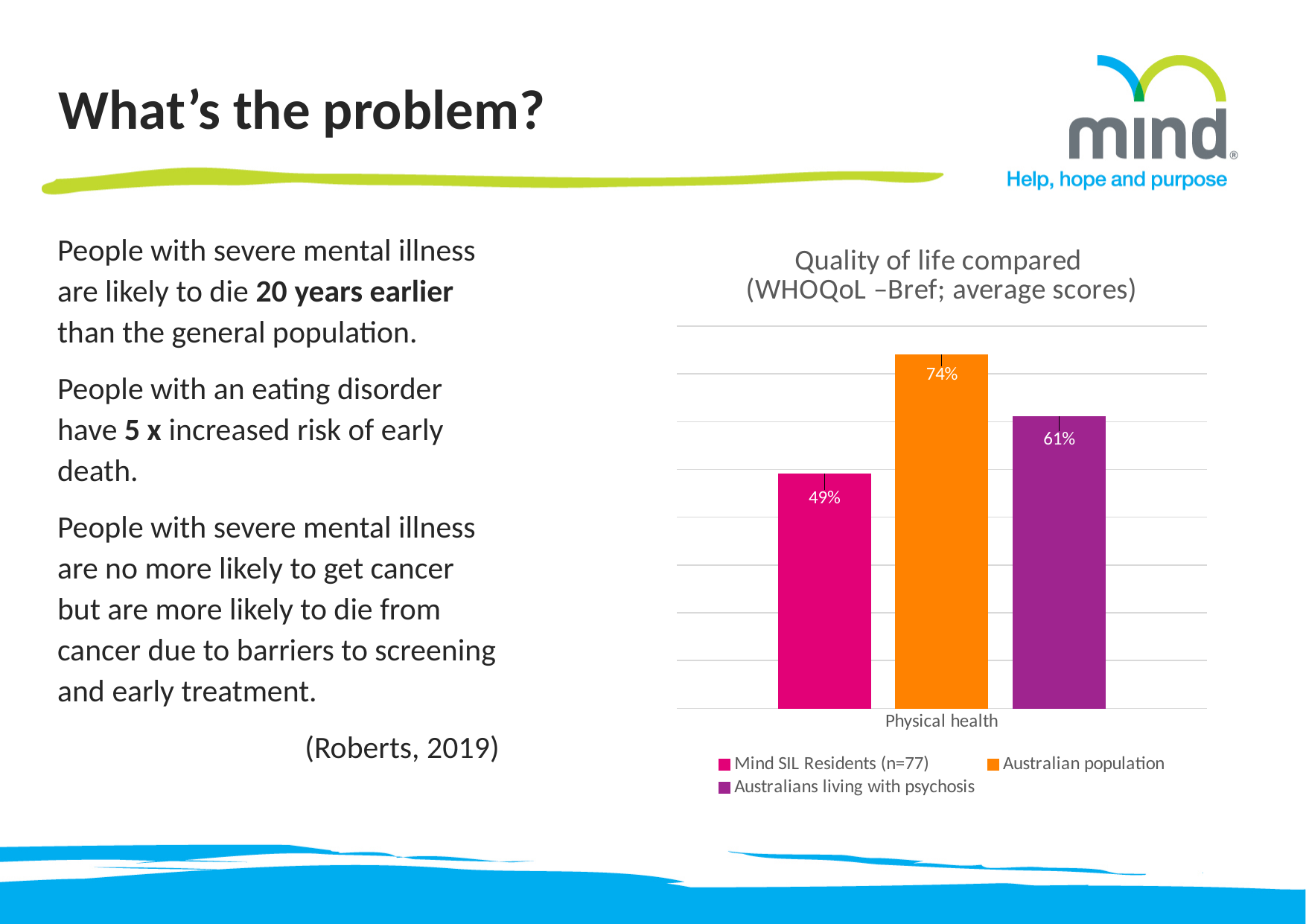
How many series does the legend list? 3 How many categories are shown on the x axis? 1 What is the value for Mind SIL Residents (n=77) for Physical health? 49% What is the difference between the Australian population value and the Mind SIL Residents (n=77) value? 25% What is the difference between the Australians living with psychosis value and the Mind SIL Residents (n=77) value? 12% What is the value for Australians living with psychosis for Physical health? 61% What is the title of the chart? Quality of life compared (WHOQoL –Bref; average scores) Which series has the lowest value for Physical health? Mind SIL Residents (n=77) What is the value for the Australian population for Physical health? 74% Which series has the highest value for Physical health? Australian population Which is larger: the value for Australians living with psychosis or the value for Mind SIL Residents (n=77)? Australians living with psychosis What kind of chart is shown on the slide? Bar chart